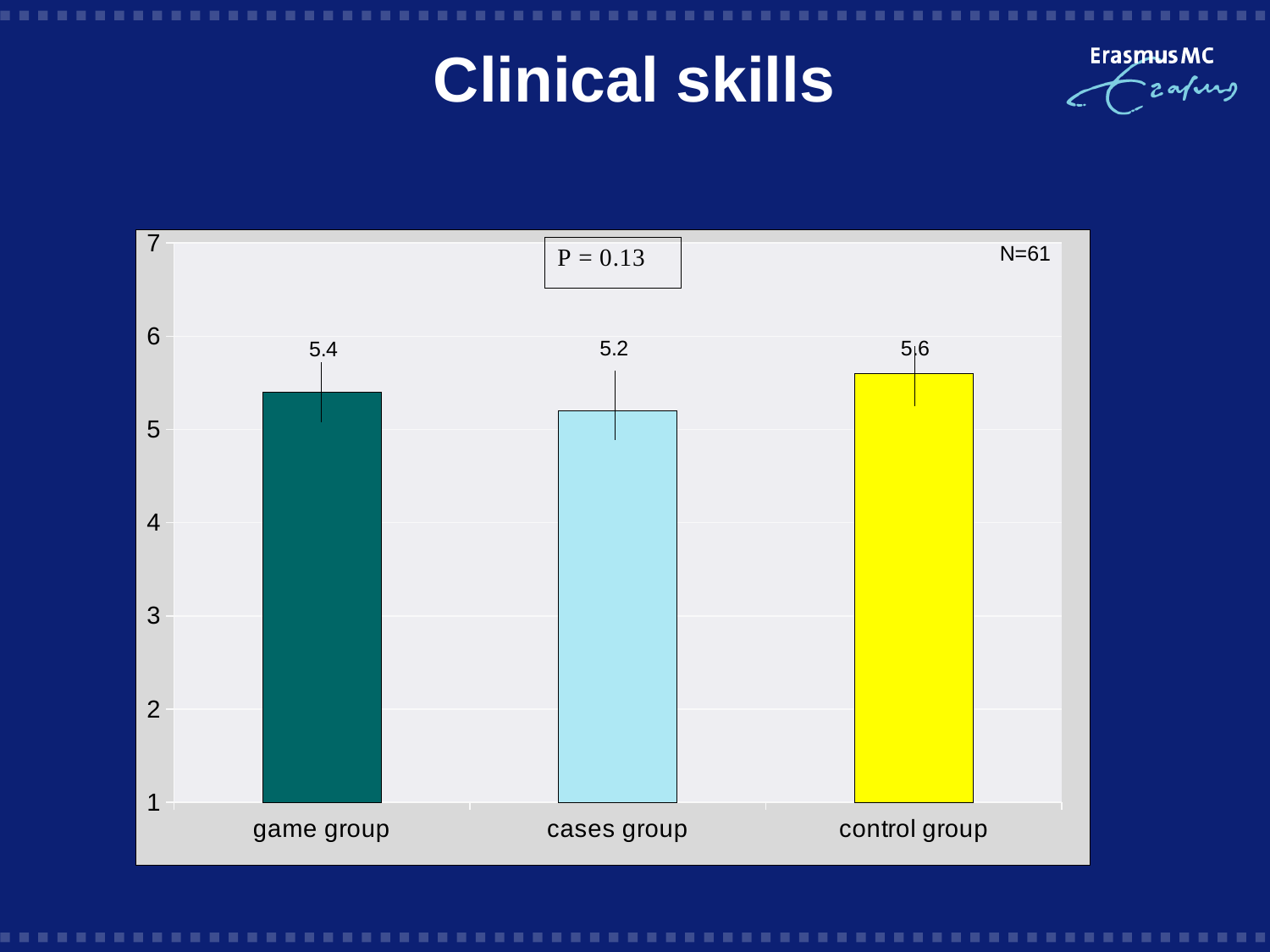
What is the difference between the control group and the cases group values? 0.4 How many groups are shown on the chart? 3 Which group has the highest value? control group What is the value for the game group? 5.4 What is the difference between the game group and the cases group values? 0.2 Which group has the lowest value? cases group What kind of chart is shown on the slide? bar chart What is the value for the control group? 5.6 What is the value for the cases group? 5.2 What P value is shown on the chart? P = 0.13 Which is larger, the value for the game group or the cases group? game group Is the value for the control group greater or less than 5? greater